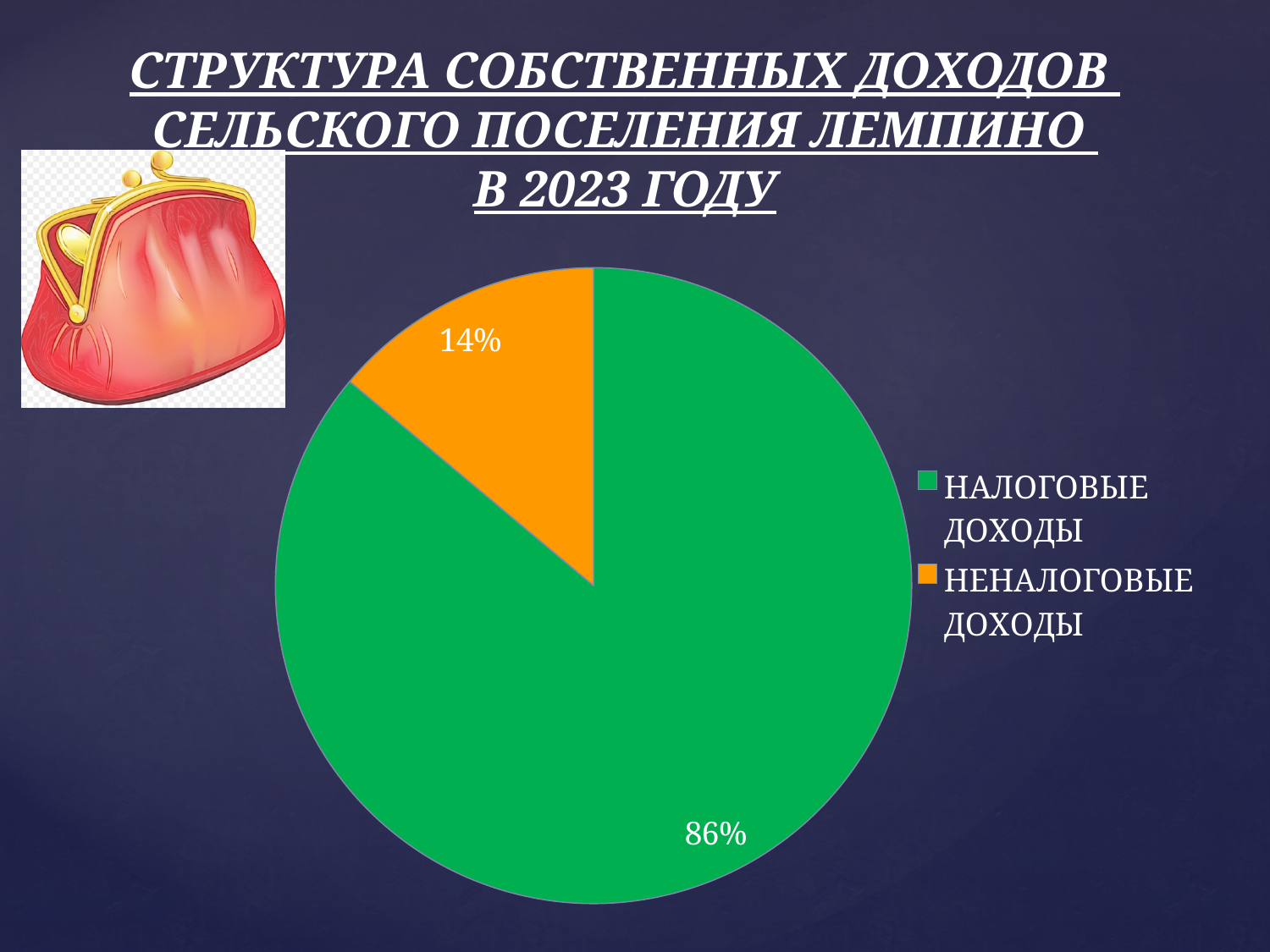
How many entries does the legend list? 2 How many slices does the pie chart have? 2 What share of the pie is labelled НАЛОГОВЫЕ ДОХОДЫ? 86% What type of chart is shown on the slide? pie chart Which is larger: the share for НАЛОГОВЫЕ ДОХОДЫ or the share for НЕНАЛОГОВЫЕ ДОХОДЫ? НАЛОГОВЫЕ ДОХОДЫ What is the difference in percentage points between НАЛОГОВЫЕ ДОХОДЫ and НЕНАЛОГОВЫЕ ДОХОДЫ? 72 What colour is the slice for НАЛОГОВЫЕ ДОХОДЫ? green Which category has the smallest slice of the pie? НЕНАЛОГОВЫЕ ДОХОДЫ Which category has the largest slice of the pie? НАЛОГОВЫЕ ДОХОДЫ What share of the pie is labelled НЕНАЛОГОВЫЕ ДОХОДЫ? 14% What colour is the slice for НЕНАЛОГОВЫЕ ДОХОДЫ? orange